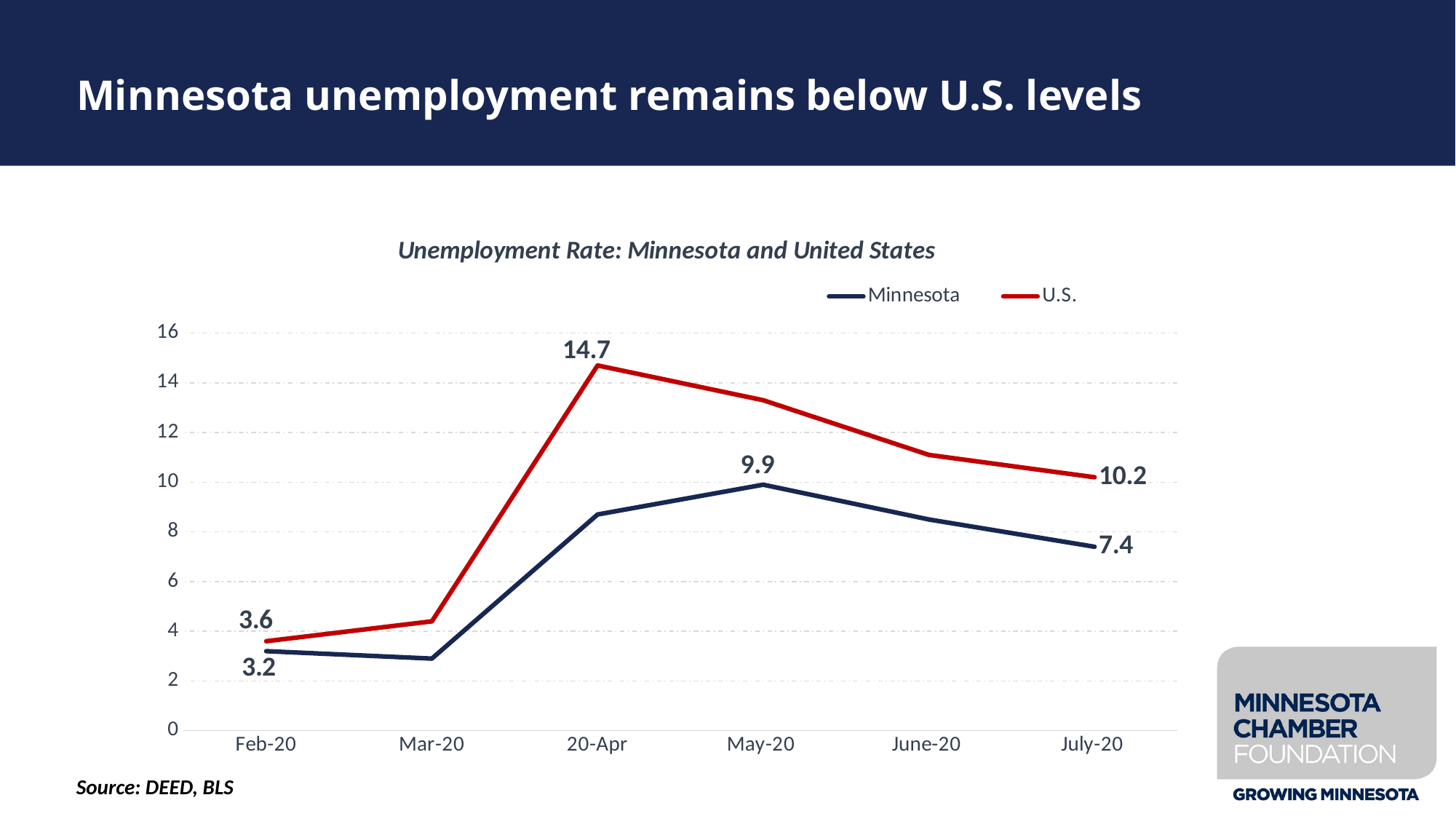
What was the Minnesota unemployment rate in July-20? 7.4 In which month did the U.S. unemployment rate reach its highest value? 20-Apr How many months are shown on the x axis of the chart? 6 In Feb-20, what was the difference between the U.S. and Minnesota unemployment rates? 0.4 Which series had the higher unemployment rate in July-20, Minnesota or U.S.? U.S. What was the U.S. unemployment rate in 20-Apr? 14.7 What was the Minnesota unemployment rate in May-20? 9.9 Is the Minnesota unemployment rate for 20-Apr greater or less than 8? greater Is the U.S. unemployment rate for June-20 greater or less than 12? less In July-20, how much higher was the U.S. unemployment rate than Minnesota's? 2.8 What was the U.S. unemployment rate in Feb-20? 3.6 How many series does the chart's legend list? 2